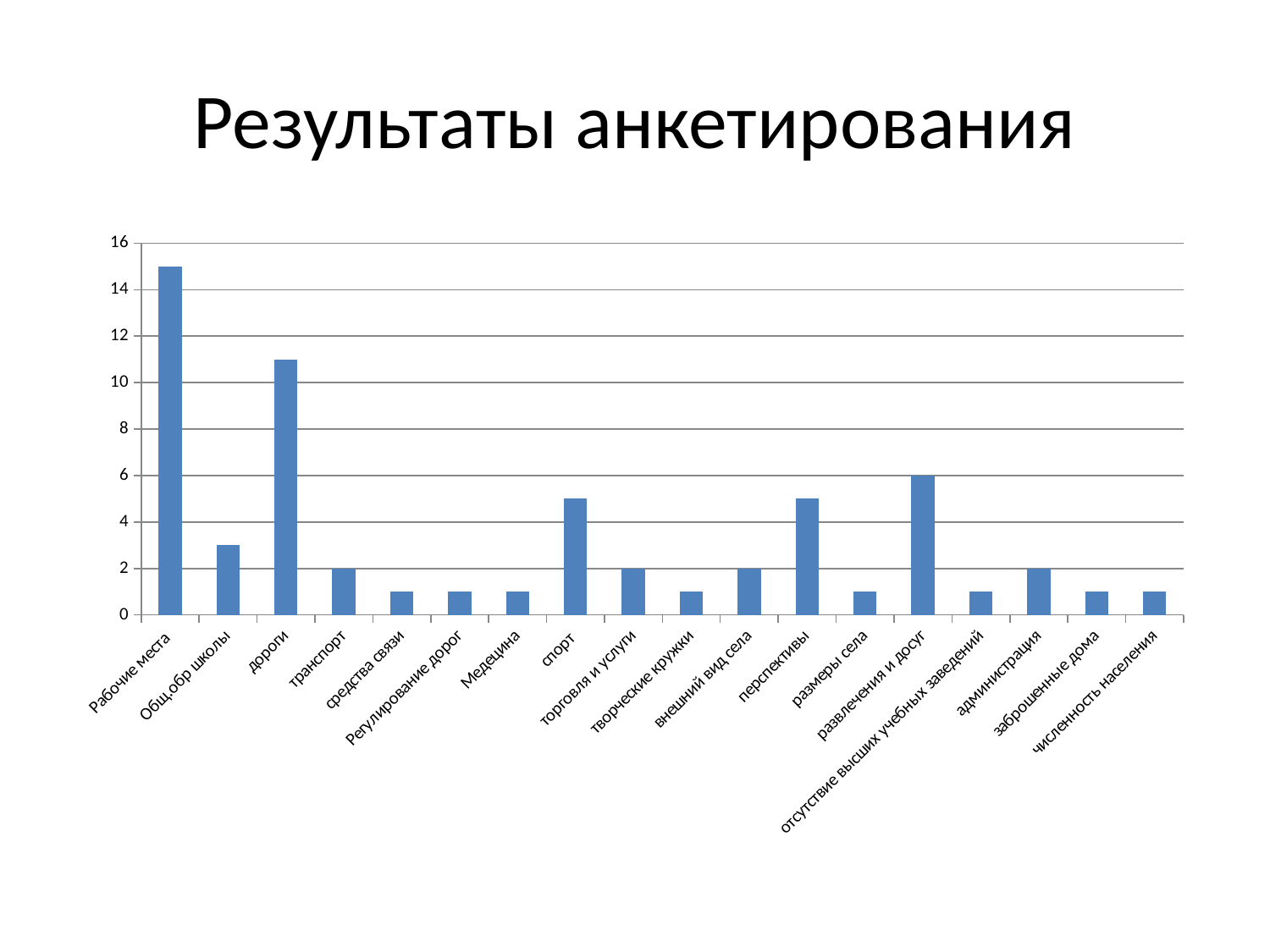
Is the value for Рабочие места greater or less than 14? greater Which category has the highest value? Рабочие места What is the title of the slide? Результаты анкетирования What kind of chart is shown on the slide? bar chart How many categories are plotted on the x axis? 18 Is the value for дороги greater or less than 10? greater What is the difference between the values for развлечения и досуг and внешний вид села? 4 What is the value for развлечения и досуг? 6 What is the value for администрация? 2 Is the value for спорт greater or less than 4? greater What is the value for транспорт? 2 Which is larger, the value for дороги or the value for перспективы? дороги